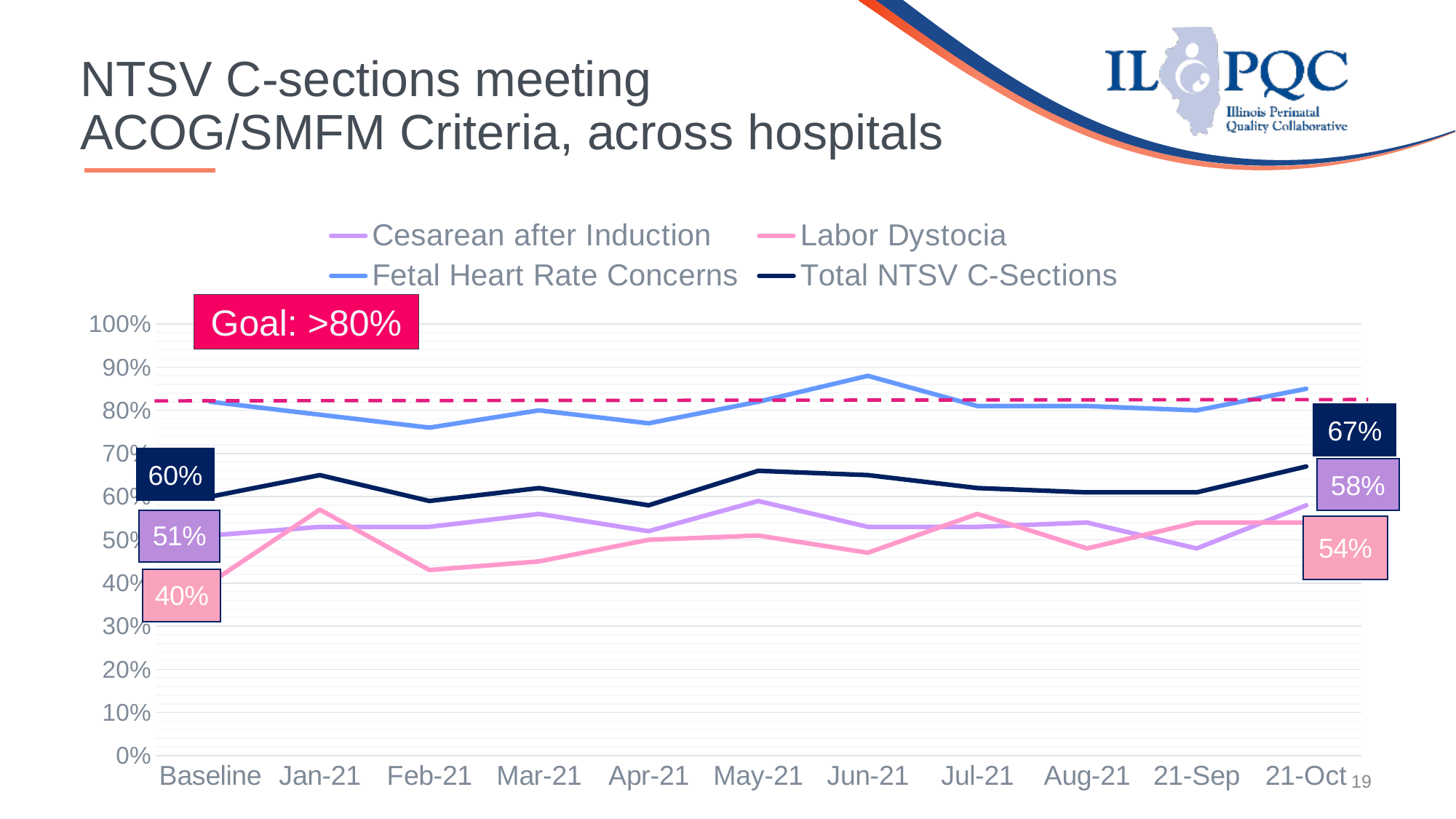
What is the value for Total NTSV C-Sections at Baseline? 60% By how many percentage points did Labor Dystocia change from Baseline (40%) to 21-Oct (54%)? 14 percentage points Which series has the highest values across the chart? Fetal Heart Rate Concerns What kind of chart is shown on the slide? line chart How many time points are shown on the x axis? 11 What is the value for Labor Dystocia at Baseline? 40% Which is larger at Baseline: Cesarean after Induction or Labor Dystocia? Cesarean after Induction What is the value for Cesarean after Induction at 21-Oct? 58% Is the value for Fetal Heart Rate Concerns at Jun-21 greater or less than 80%? greater What is the value for Total NTSV C-Sections at 21-Oct? 67% How many series does the legend list? 4 What goal is stated on the chart? Goal: >80%